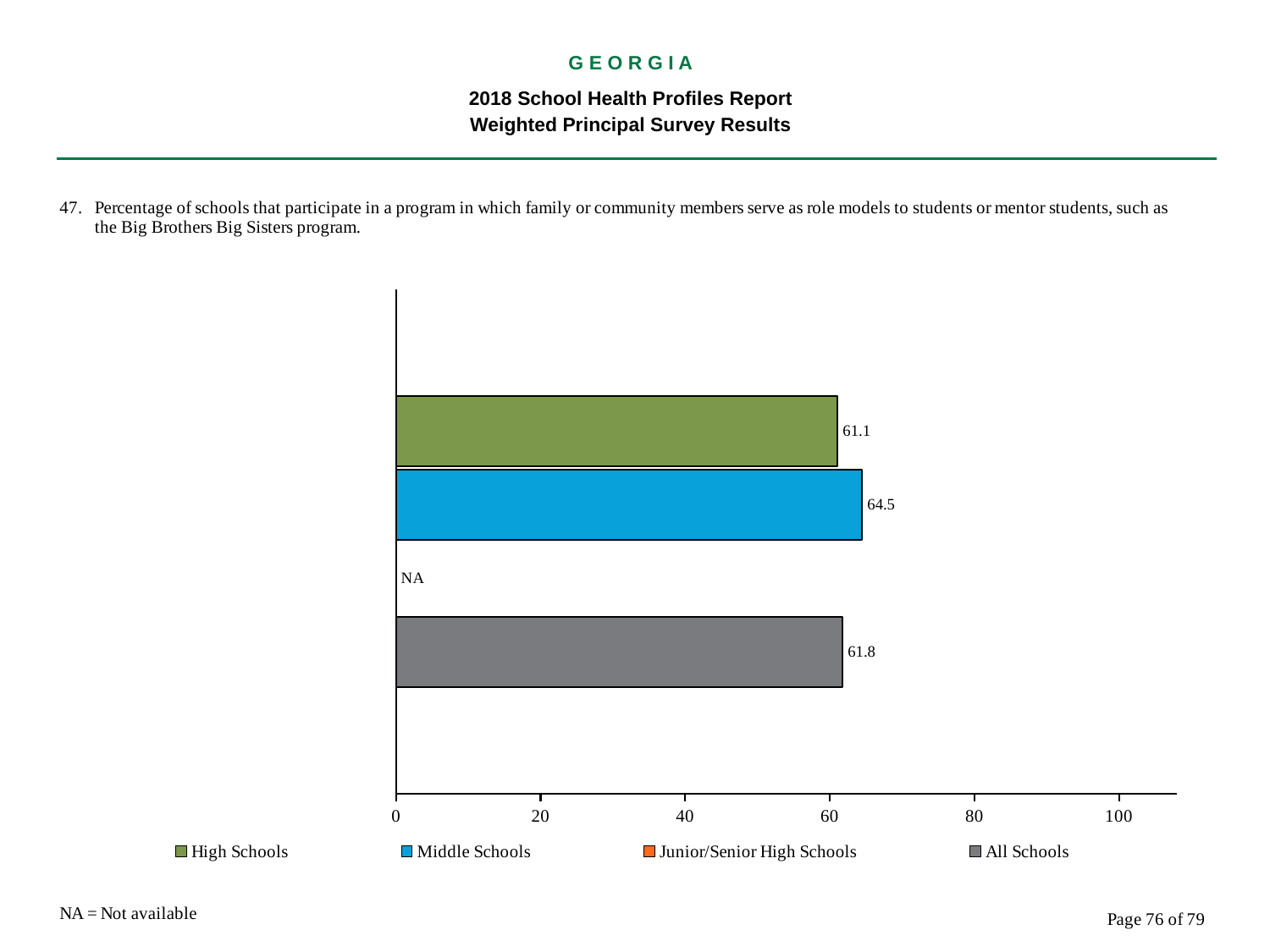
What is the difference between the All Schools value and the High Schools value? 0.7 What is the value for All Schools? 61.8 How many series does the legend list? 4 What is the value for High Schools? 61.1 Which school type has the highest value? Middle Schools What is the value for Middle Schools? 64.5 Which school type with a plotted value has the lowest value? High Schools What is the difference between the Middle Schools value and the High Schools value? 3.4 What kind of chart is shown? Bar chart What does NA stand for according to the note on the slide? Not available Which is larger, the value for Middle Schools or the value for All Schools? Middle Schools What is shown for Junior/Senior High Schools? NA